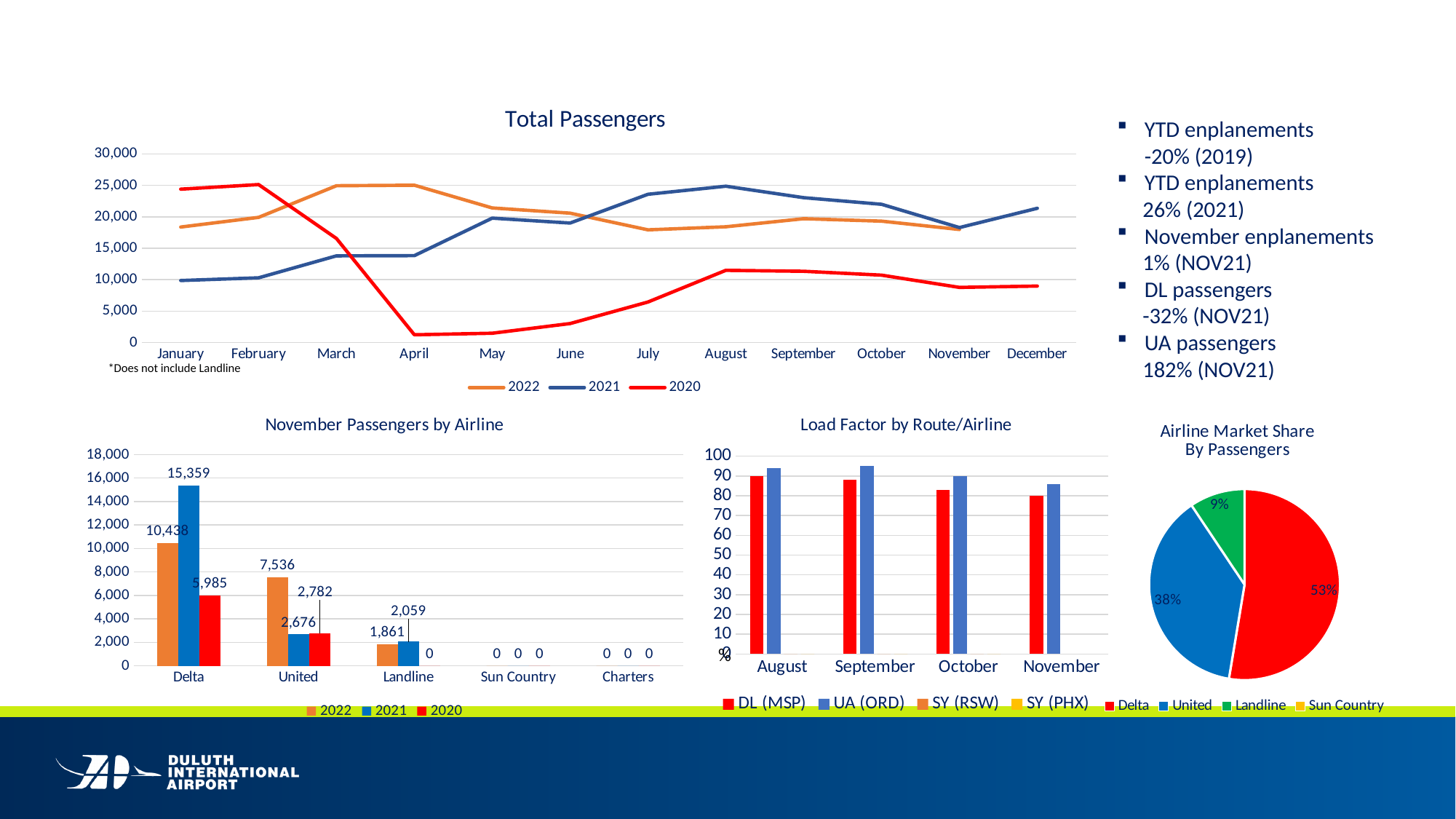
In the "Load Factor by Route/Airline" chart, is the DL (MSP) value for November greater or less than 90? less In the "November Passengers by Airline" chart, what is the difference between the 2021 and 2022 values for Delta? 4,921 In the "Total Passengers" chart, does the 2020 line rise or fall from February to April? fall How many series does the legend of the "Load Factor by Route/Airline" chart list? 4 In the "November Passengers by Airline" chart, what is the 2021 value for Delta? 15,359 In the "November Passengers by Airline" chart, how many categories are shown on the x axis? 5 In the "Airline Market Share By Passengers" pie chart, what share does Delta have? 53% What kind of chart is the "Total Passengers" chart? line chart How many series does the legend of the "Total Passengers" chart list? 3 In the "November Passengers by Airline" chart, what is the 2022 value for United? 7,536 In the "Total Passengers" chart, is the 2020 value for April greater or less than 5,000? less In the "November Passengers by Airline" chart, which airline has the highest 2022 value? Delta